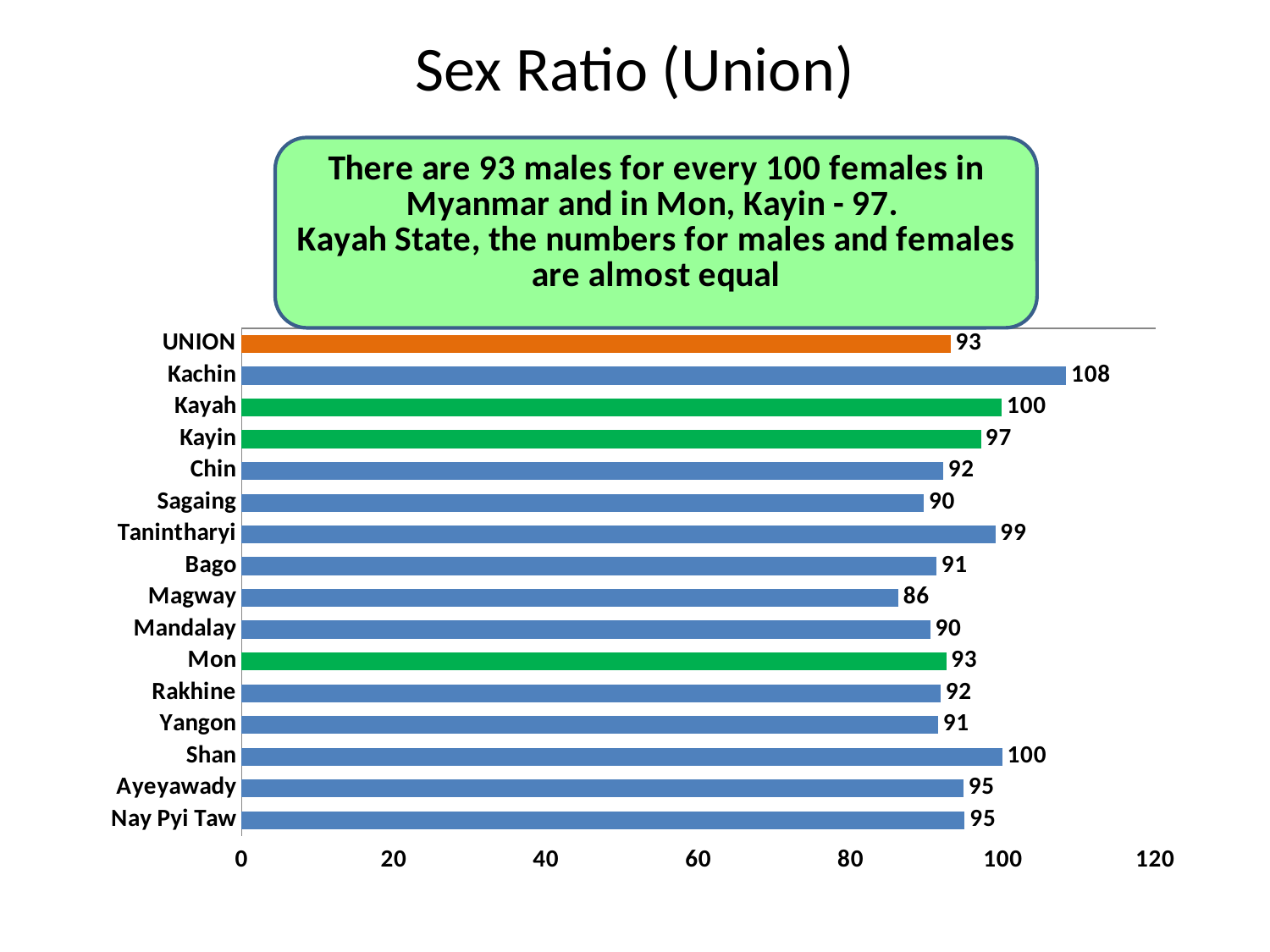
What kind of chart is shown on the slide? bar chart What is the difference between the sex ratio for Kayah and for Mon? 7 What is the sex ratio value for UNION? 93 What is the difference between the sex ratio for Kachin and for Magway? 22 Which category has the highest sex ratio? Kachin How many categories (bars) are shown in the chart? 16 What is the sex ratio value for Kachin? 108 What is the sex ratio value for Magway? 86 What colour is the bar for UNION? orange Which category has the lowest sex ratio? Magway Which has a larger sex ratio, Tanintharyi or Sagaing? Tanintharyi Is the value for Shan greater or less than 80? greater